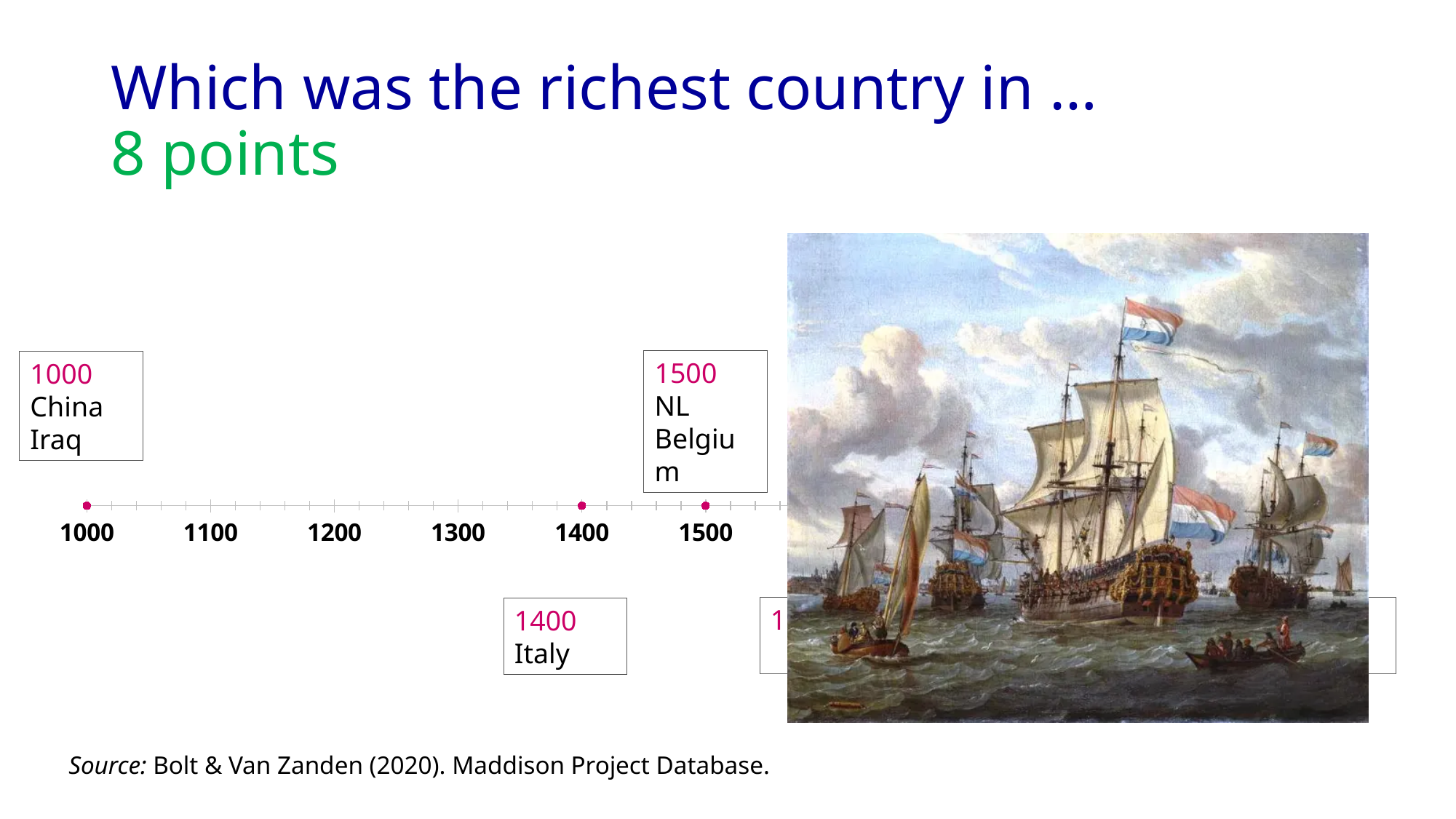
How many countries are listed in the box for the year 1500? 2 How many countries are listed in the box for the year 1000? 2 Which countries are listed in the box for the year 1500? NL and Belgium What source is cited for the timeline? Bolt & Van Zanden (2020). Maddison Project Database. In which year is Italy marked as the richest country on the timeline? 1400 Which country is labelled as the richest in 1400 on the timeline? Italy What is the earliest year shown on the timeline axis? 1000 Which year comes first on the timeline, the one labelled Italy or the one labelled NL and Belgium? The one labelled Italy (1400) What is the interval between the labelled ticks on the timeline axis? 100 years What kind of chart is shown on the slide? A timeline Which countries are listed in the box for the year 1000? China and Iraq